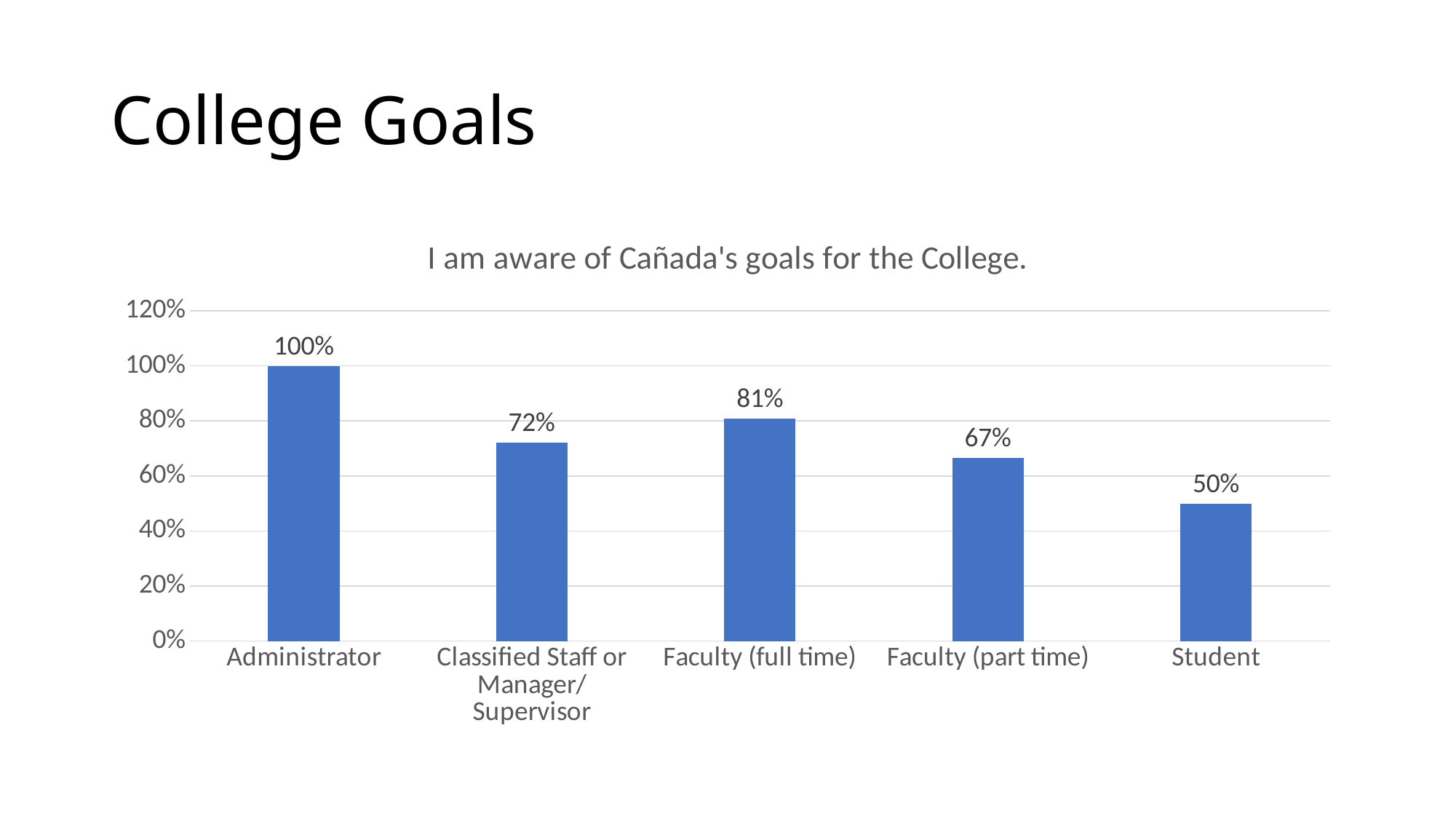
What kind of chart is shown on the slide? Bar chart What is the title of the chart? I am aware of Cañada's goals for the College. Which is larger, the value for Faculty (full time) or the value for Classified Staff or Manager/Supervisor? Faculty (full time) Which category has the lowest value? Student What is the difference between the values for Faculty (full time) and Faculty (part time)? 14% What is the value shown for Classified Staff or Manager/Supervisor? 72% What is the value shown for Faculty (part time)? 67% What percentage of Administrators agreed with the statement 'I am aware of Cañada's goals for the College'? 100% Is the value for Student greater or less than 60%? less How many categories are shown on the x axis? 5 What is the difference between the values for Administrator and Student? 50% Which category has the highest value? Administrator